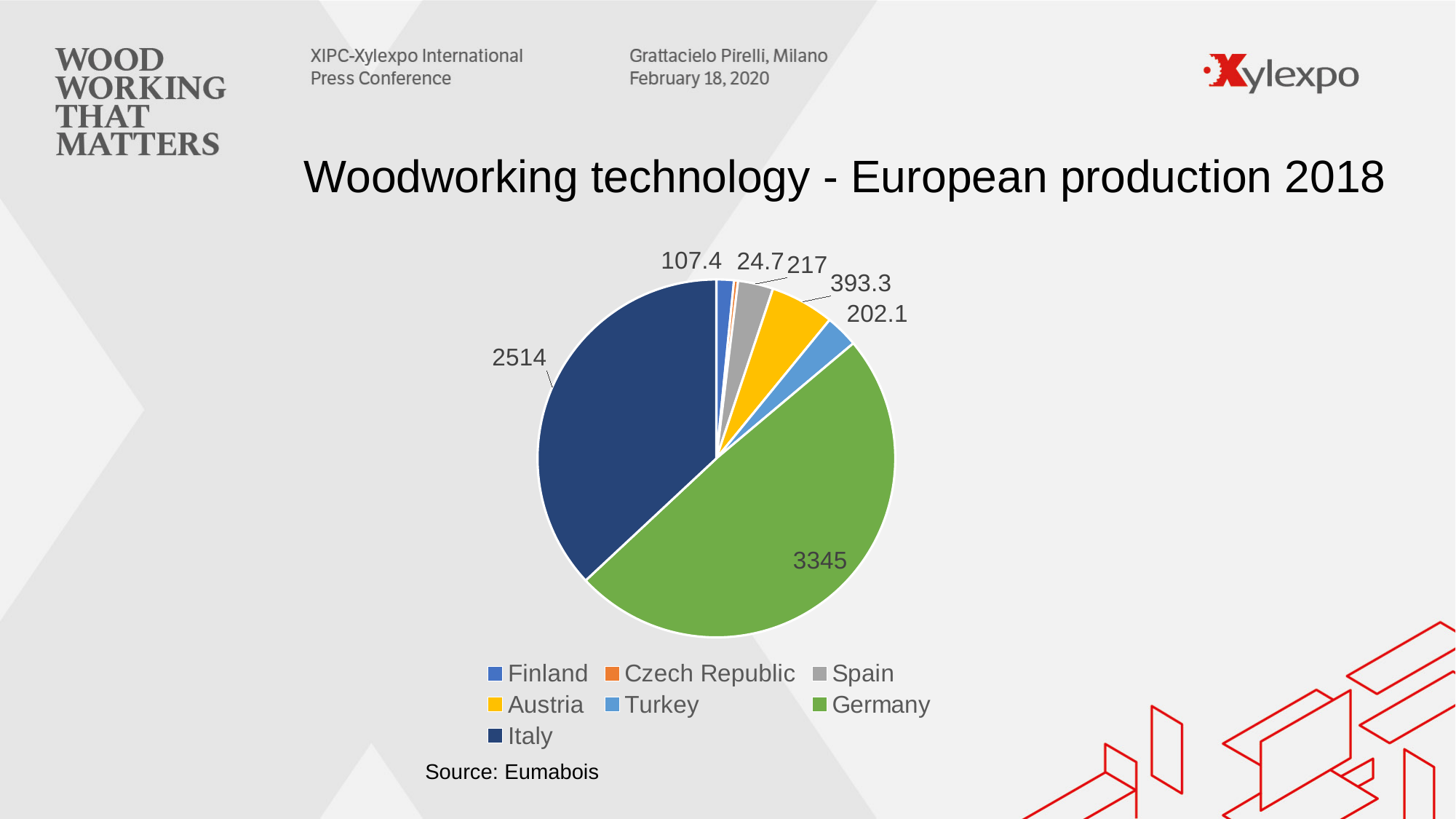
How many countries are shown in the pie chart? 7 What is the difference between the values for Austria and Spain? 176.3 What is the title of the chart on the slide? Woodworking technology - European production 2018 What type of chart is shown on the slide? Pie chart What is the difference between the values for Germany and Italy? 831 Which country has the smallest slice of the pie chart? Czech Republic What is the value for Austria in the pie chart? 393.3 Which country has the largest slice of the pie chart? Germany Which is larger, the value for Turkey or the value for Finland? Turkey What is the value for the Czech Republic in the pie chart? 24.7 What is the value for Germany in the pie chart? 3345 What is the value for Italy in the pie chart? 2514